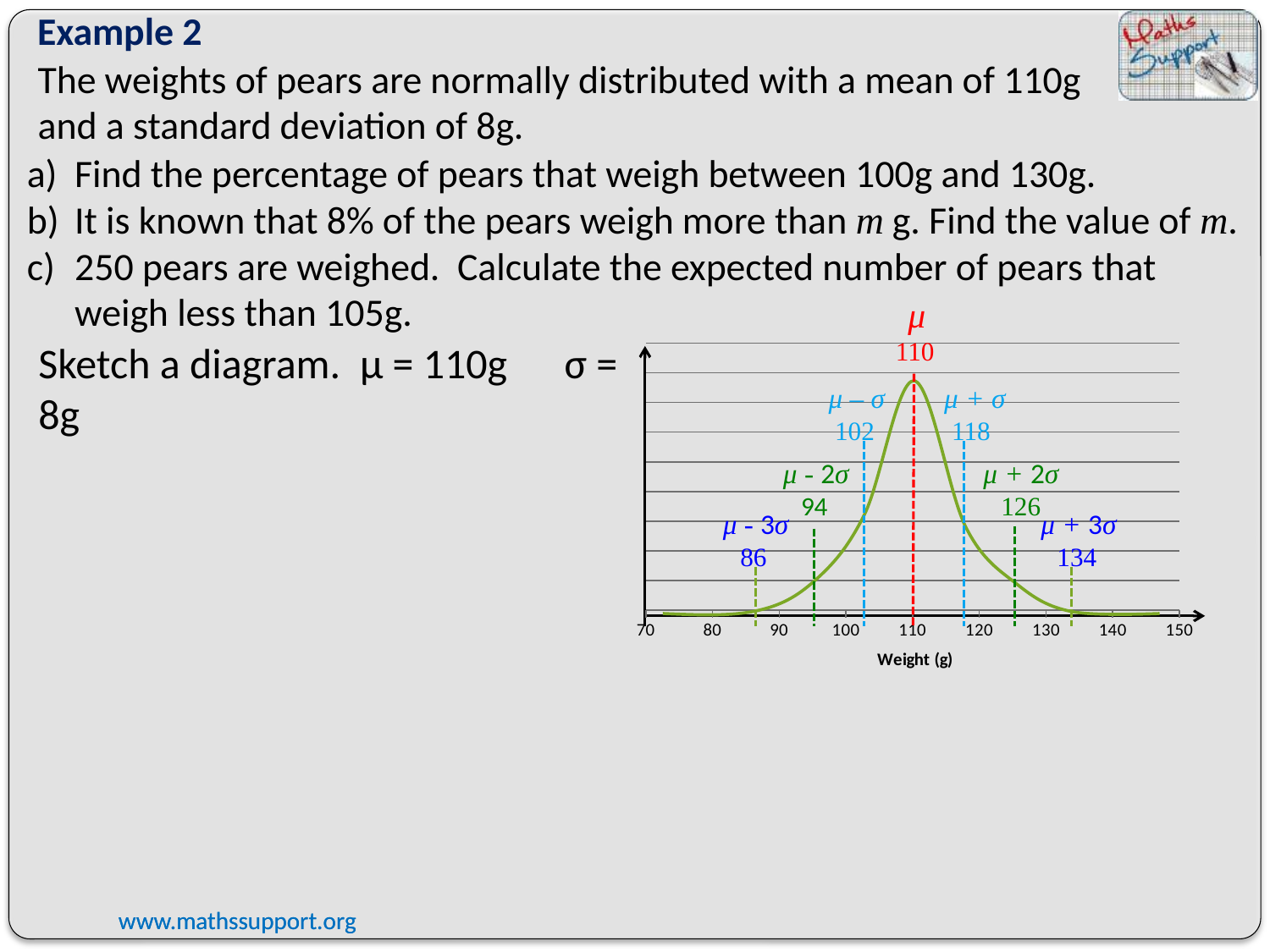
How many vertical dashed marker lines are drawn on the chart? 7 At which weight does the curve reach its highest point? 110 What is the difference between the weights marked at μ + σ and μ – σ? 16 What kind of chart is shown on the slide? line chart What weight is marked at μ on the chart? 110 What weight is marked at μ - 2σ on the chart? 94 Is the weight marked at μ + 3σ greater or less than 130? greater What is the label on the horizontal axis of the chart? Weight (g) What weight is marked at μ – σ on the chart? 102 What weight is marked at μ + 3σ on the chart? 134 Does the curve rise or fall as weight increases from 110 to 150? fall What weight is marked at μ + σ on the chart? 118